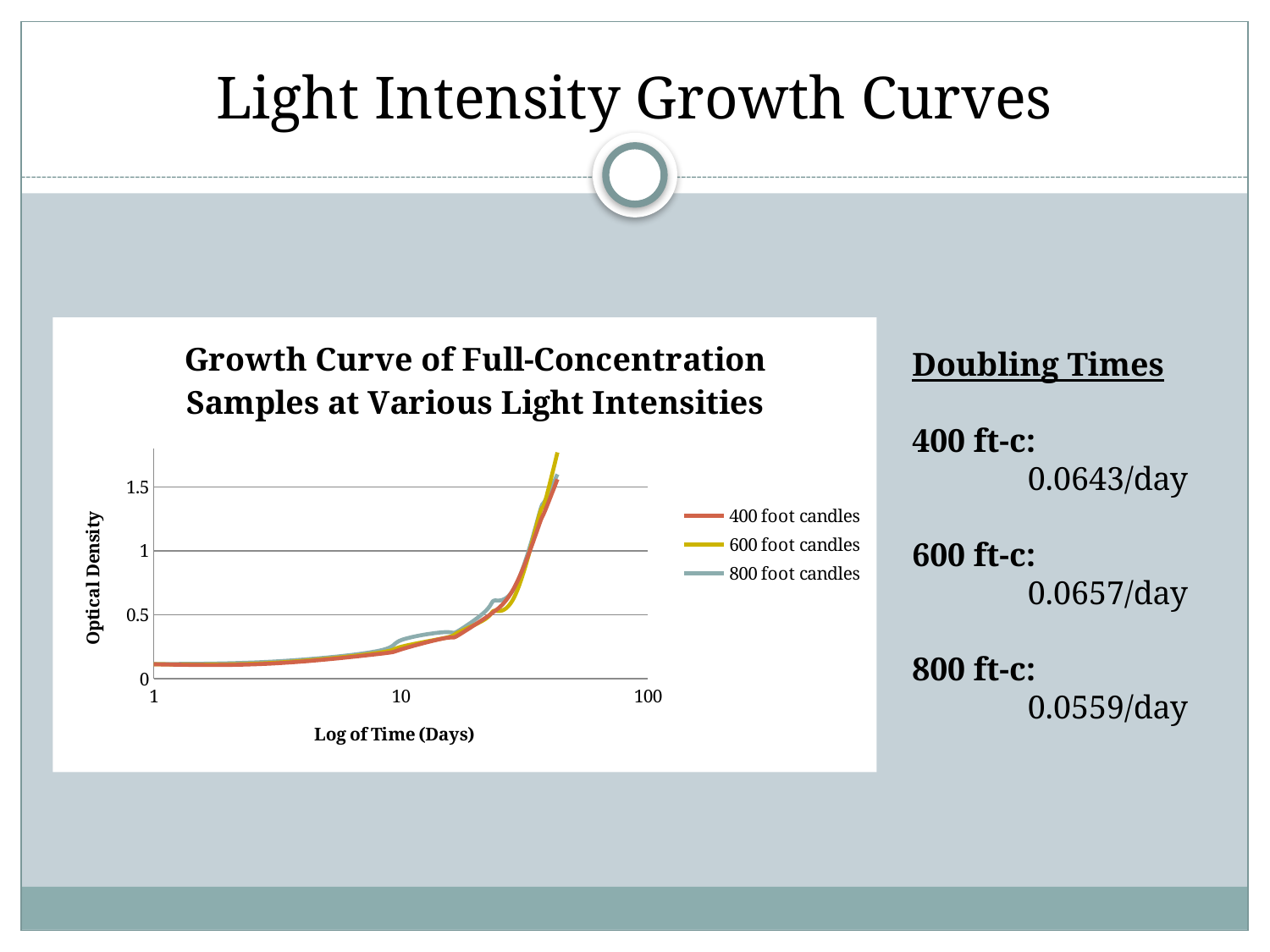
Is the optical density for 400 foot candles at day 10 greater or less than 0.5? less Is the optical density for 800 foot candles at day 10 greater or less than 0.5? less Which series reaches the highest optical density at the end of the curves? 600 foot candles Is the final optical density reached by the 600 foot candles series greater or less than 1.5? greater What is the label of the chart's y axis? Optical Density What kind of chart is shown on the slide? line chart Do the optical density values rise or fall as time increases along the x axis? rise What is the title of the chart? Growth Curve of Full-Concentration Samples at Various Light Intensities How many series does the chart's legend list? 3